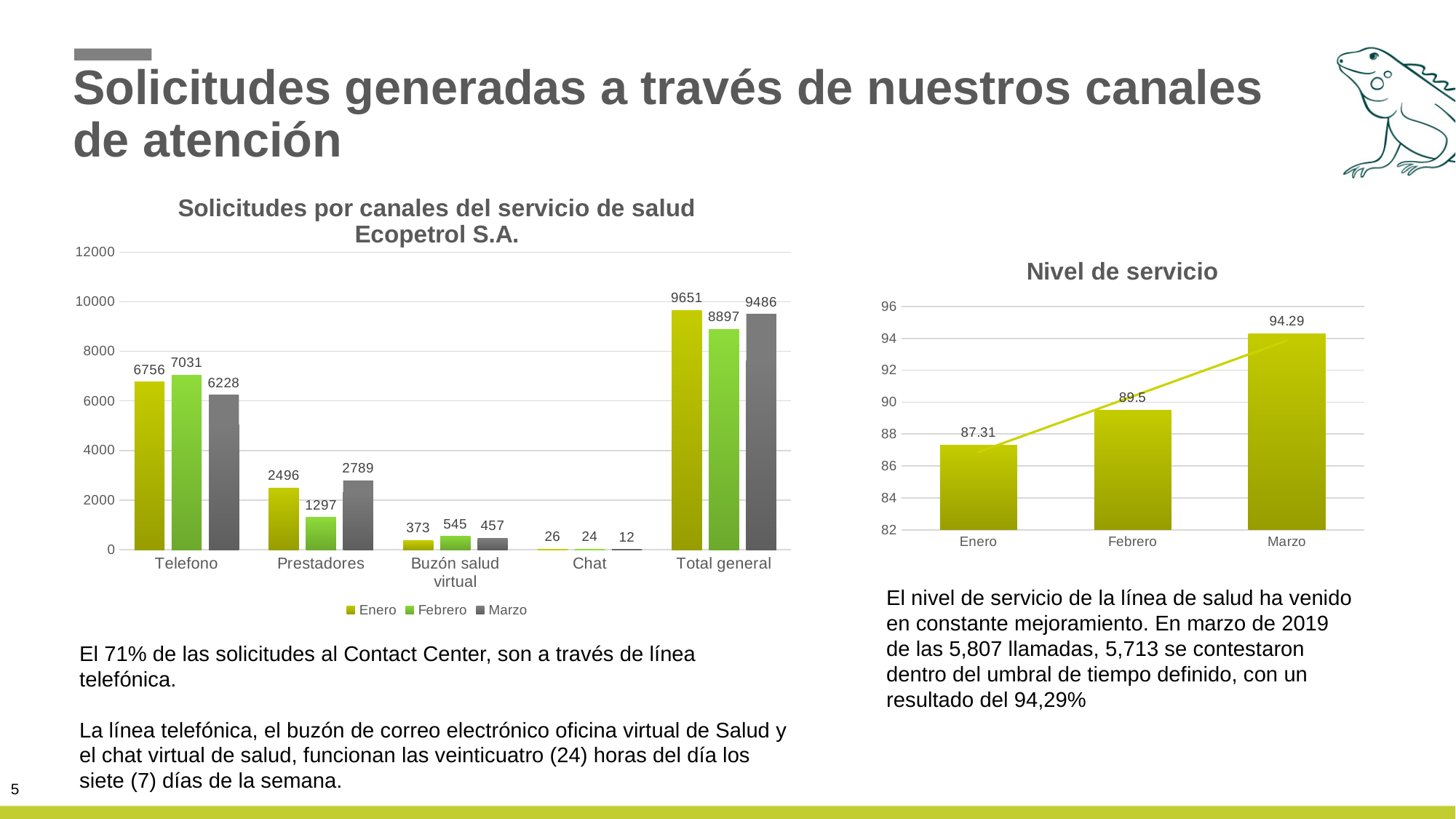
In the 'Nivel de servicio' chart, what is the difference between the values for Marzo and Enero? 6.98 In the 'Nivel de servicio' chart, what is the value for Febrero? 89.5 In the 'Solicitudes por canales del servicio de salud Ecopetrol S.A.' chart, which month has the lowest value for Chat? Marzo In the 'Solicitudes por canales del servicio de salud Ecopetrol S.A.' chart, what is the value for Telefono in Febrero? 7031 In the 'Solicitudes por canales del servicio de salud Ecopetrol S.A.' chart, which is larger: Buzón salud virtual in Febrero or in Marzo? Febrero What kind of chart is the 'Nivel de servicio' chart? bar chart In the 'Nivel de servicio' chart, which month has the highest value? Marzo In the 'Solicitudes por canales del servicio de salud Ecopetrol S.A.' chart, what is the value for Prestadores in Marzo? 2789 In the 'Solicitudes por canales del servicio de salud Ecopetrol S.A.' chart, how many categories are shown on the x axis? 5 In the 'Solicitudes por canales del servicio de salud Ecopetrol S.A.' chart, what is the difference between the Total general values for Enero and Febrero? 754 In the 'Solicitudes por canales del servicio de salud Ecopetrol S.A.' chart, how many series does the legend list? 3 In the 'Nivel de servicio' chart, do the values rise or fall from Enero to Marzo? rise